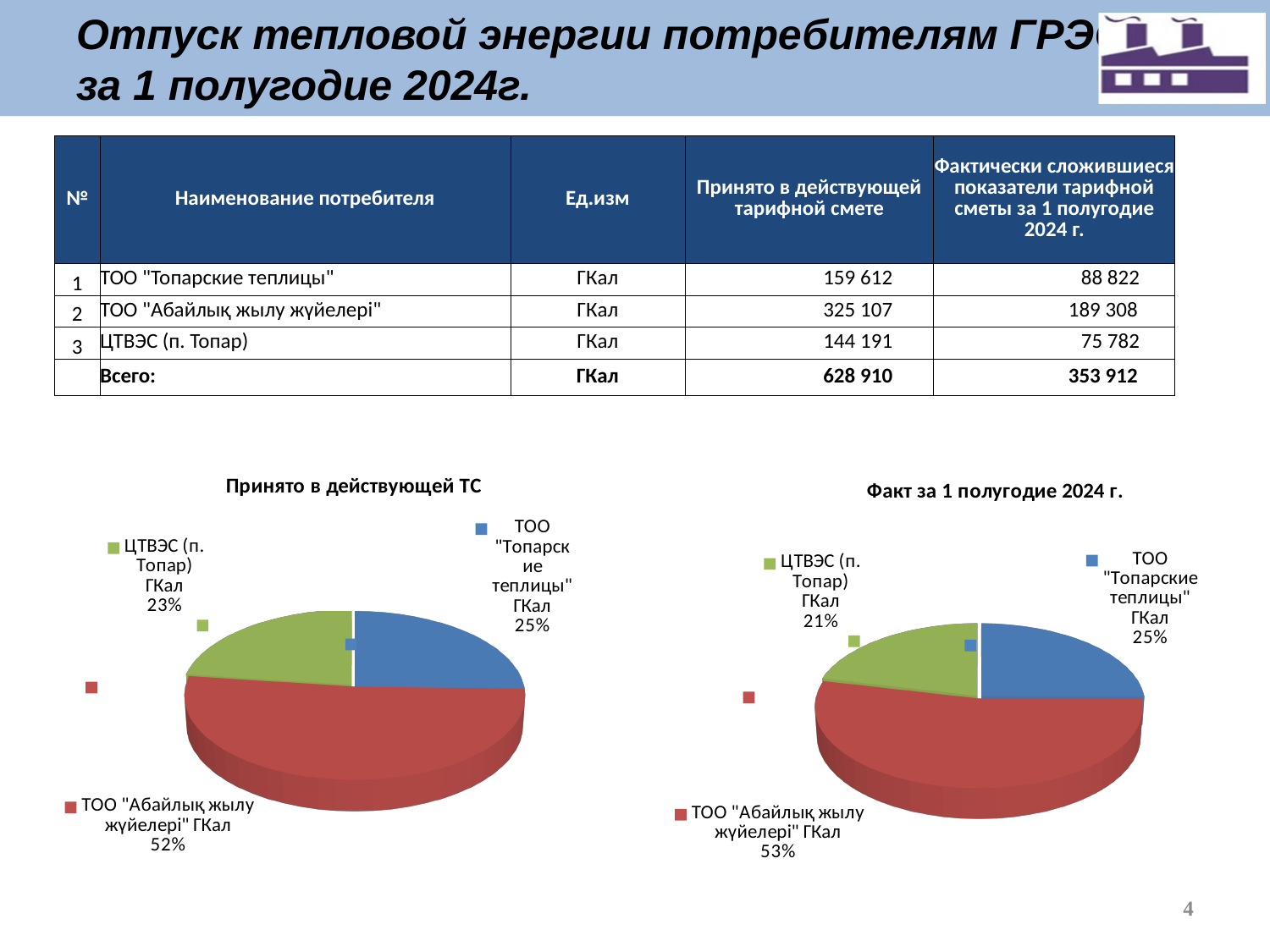
In the chart titled "Принято в действующей ТС", which consumer has the largest slice? ТОО "Абайлық жылу жүйелері" In the chart titled "Принято в действующей ТС", what colour is the slice for ТОО "Абайлық жылу жүйелері"? Red How many slices does the chart titled "Принято в действующей ТС" have? 3 In the chart titled "Принято в действующей ТС", what share of the pie does ЦТВЭС (п. Топар) have? 23% What kind of chart is the chart titled "Факт за 1 полугодие 2024 г."? Pie chart In the chart titled "Факт за 1 полугодие 2024 г.", which is larger: the share of ТОО "Топарские теплицы" or the share of ЦТВЭС (п. Топар)? ТОО "Топарские теплицы" In the chart titled "Факт за 1 полугодие 2024 г.", what share of the pie does ТОО "Абайлық жылу жүйелері" have? 53% In the chart titled "Факт за 1 полугодие 2024 г.", which consumer has the smallest slice? ЦТВЭС (п. Топар) In the chart titled "Факт за 1 полугодие 2024 г.", what share of the pie does ТОО "Топарские теплицы" have? 25% In the chart titled "Принято в действующей ТС", how many percentage points larger is the share of ТОО "Абайлық жылу жүйелері" than that of ЦТВЭС (п. Топар)? 29 percentage points